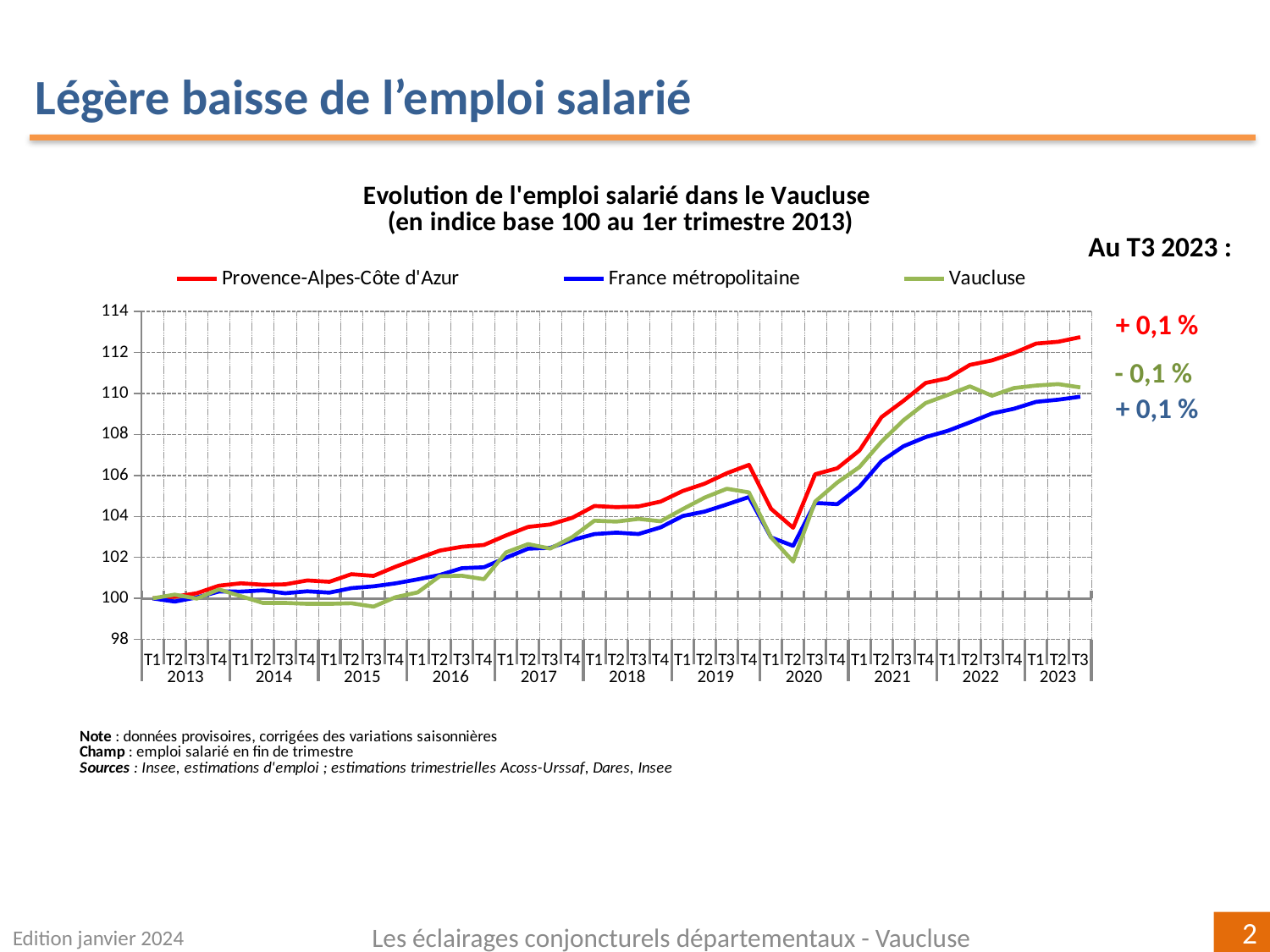
What change is annotated for Provence-Alpes-Côte d'Azur at T3 2023? + 0,1 % How many series does the legend list? 3 What is the title of the chart? Evolution de l'emploi salarié dans le Vaucluse (en indice base 100 au 1er trimestre 2013) Which series has the lowest value at T2 2020? Vaucluse Which series has the highest value at T3 2023? Provence-Alpes-Côte d'Azur What change is annotated for Vaucluse at T3 2023? - 0,1 % Which three series are listed in the legend? Provence-Alpes-Côte d'Azur, France métropolitaine, Vaucluse Is the value for Vaucluse at T2 2020 greater or less than 104? less Is the value for France métropolitaine at T3 2023 greater or less than 108? greater Overall, do the values rise or fall from T1 2013 to T3 2023? rise Is the value for Provence-Alpes-Côte d'Azur at T3 2023 greater or less than 112? greater What kind of chart is shown on the slide? line chart